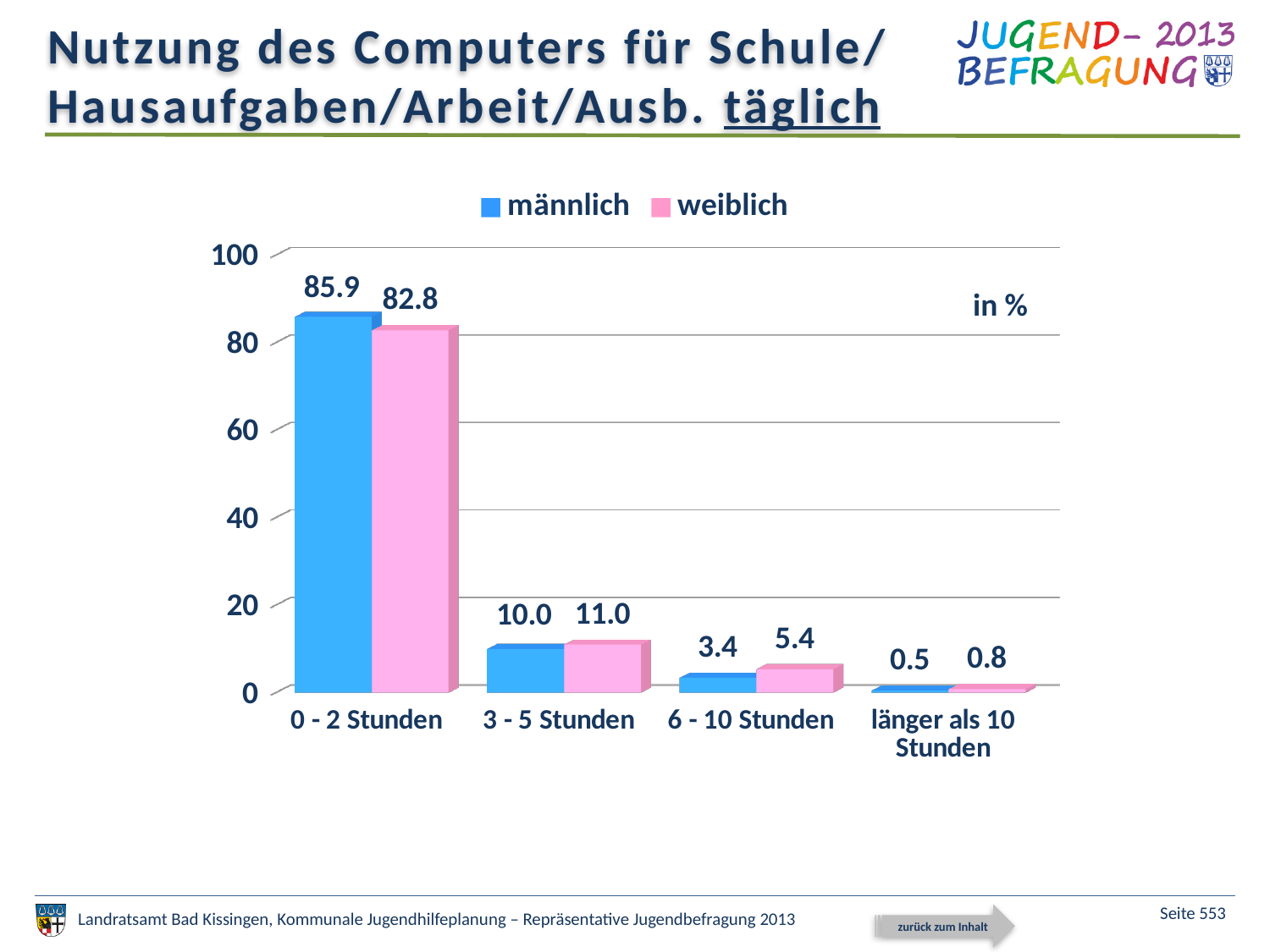
What is the value for weiblich in the 6 - 10 Stunden category? 5.4 What is the value for weiblich in the 3 - 5 Stunden category? 11.0 What is the value for männlich in the länger als 10 Stunden category? 0.5 Which category has the highest value for weiblich? 0 - 2 Stunden What kind of chart is shown on the slide? bar chart Is the value for weiblich in the 0 - 2 Stunden category greater or less than 80? greater What is the difference between the männlich and weiblich values in the 0 - 2 Stunden category? 3.1 How many categories are shown on the x axis? 4 In the 6 - 10 Stunden category, which series has the larger value, männlich or weiblich? weiblich Which category has the lowest value for männlich? länger als 10 Stunden How many series does the legend list? 2 What is the value for männlich in the 0 - 2 Stunden category? 85.9